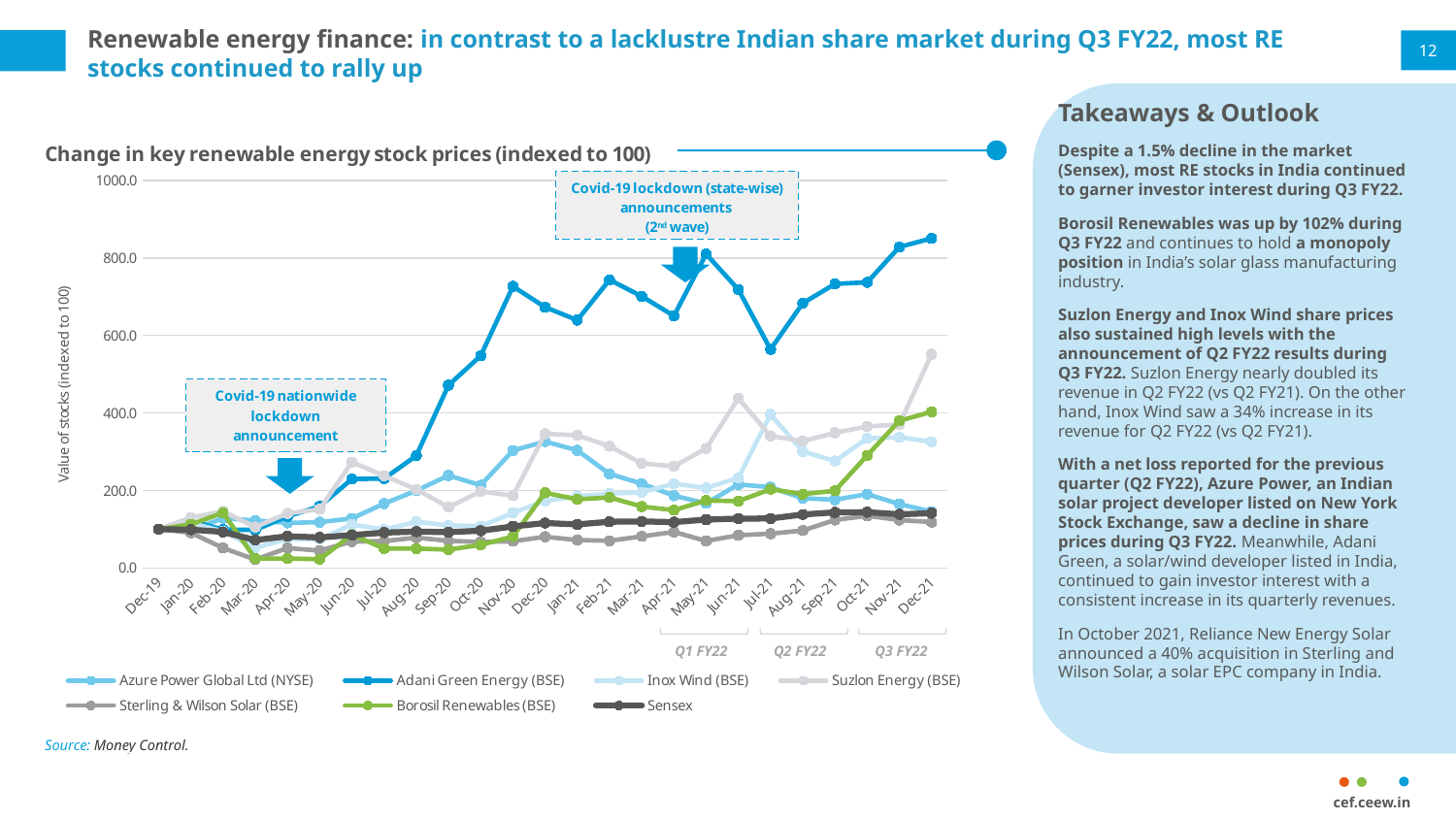
What kind of chart is shown on the slide? Line chart How many monthly points are plotted along the x axis of the chart (Dec-19 to Dec-21)? 25 Which series has the highest value at Dec-21? Adani Green Energy (BSE) At Dec-21, which is larger: Borosil Renewables (BSE) or Sensex? Borosil Renewables (BSE) Is the value for Borosil Renewables (BSE) at Mar-20 greater or less than 200.0? less Is the value for Adani Green Energy (BSE) at Dec-21 greater or less than 800.0? greater Is the value for Suzlon Energy (BSE) at Dec-21 greater or less than 400.0? greater What is the title of the chart? Change in key renewable energy stock prices (indexed to 100) What is the y-axis label of the chart? Value of stocks (indexed to 100) How many series does the legend of the chart list? 7 Does the Adani Green Energy (BSE) line overall rise or fall from Dec-19 to Dec-21? Rise